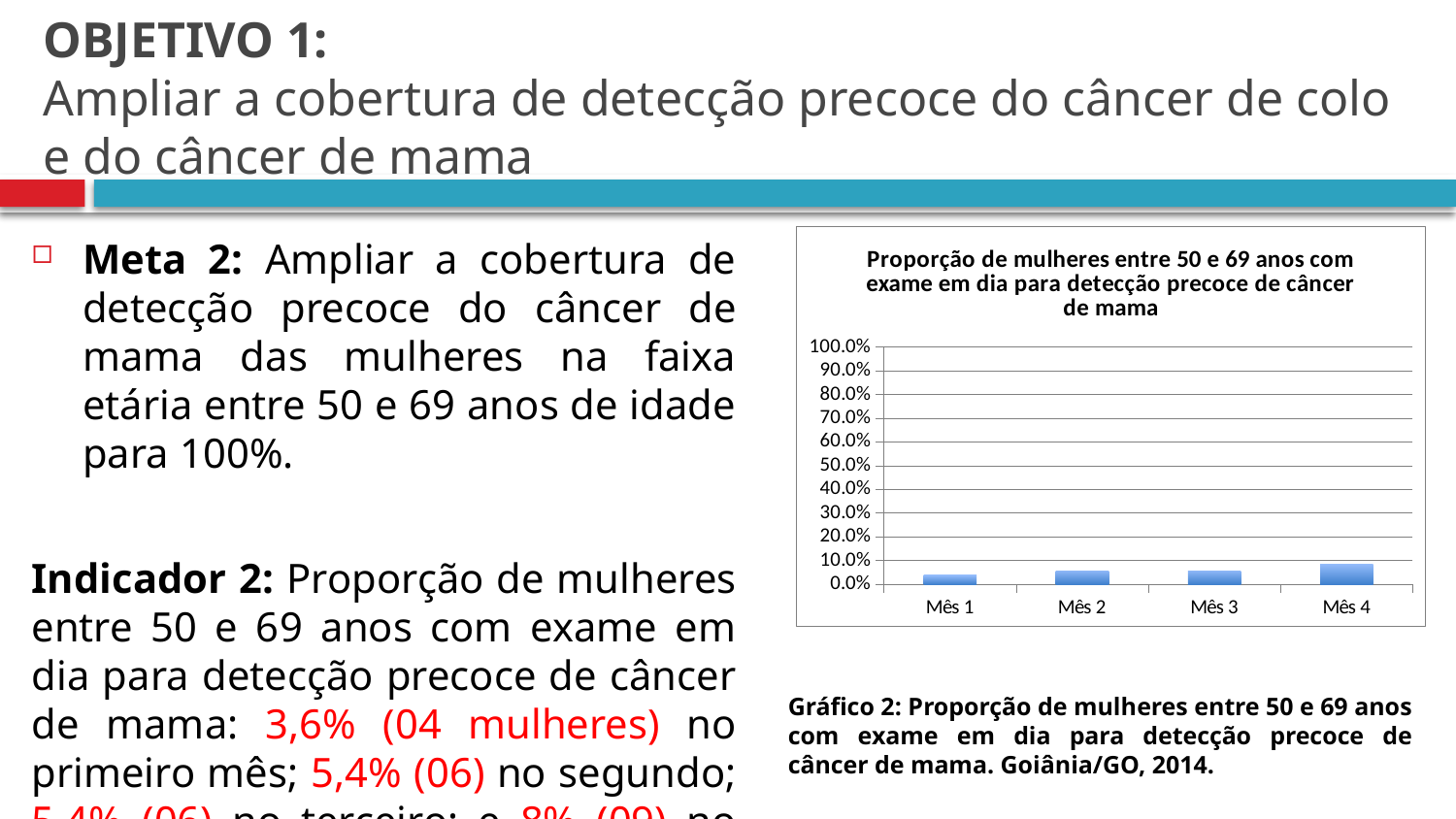
Which is larger, the value for Mês 1 or the value for Mês 2? Mês 2 What kind of chart is shown on the slide? bar chart What is the maximum value shown on the chart's y axis? 100.0% How many categories are shown on the x axis of the chart? 4 Is the value for Mês 2 greater or less than 20.0%? less Is the value for Mês 1 greater or less than 10.0%? less Do the values generally rise or fall from Mês 1 to Mês 4? rise Is the value for Mês 4 greater or less than 10.0%? less Which month has the lowest bar in the chart? Mês 1 What is the title of the chart? Proporção de mulheres entre 50 e 69 anos com exame em dia para detecção precoce de câncer de mama Which month has the highest bar in the chart? Mês 4 Which is larger, the value for Mês 1 or the value for Mês 4? Mês 4